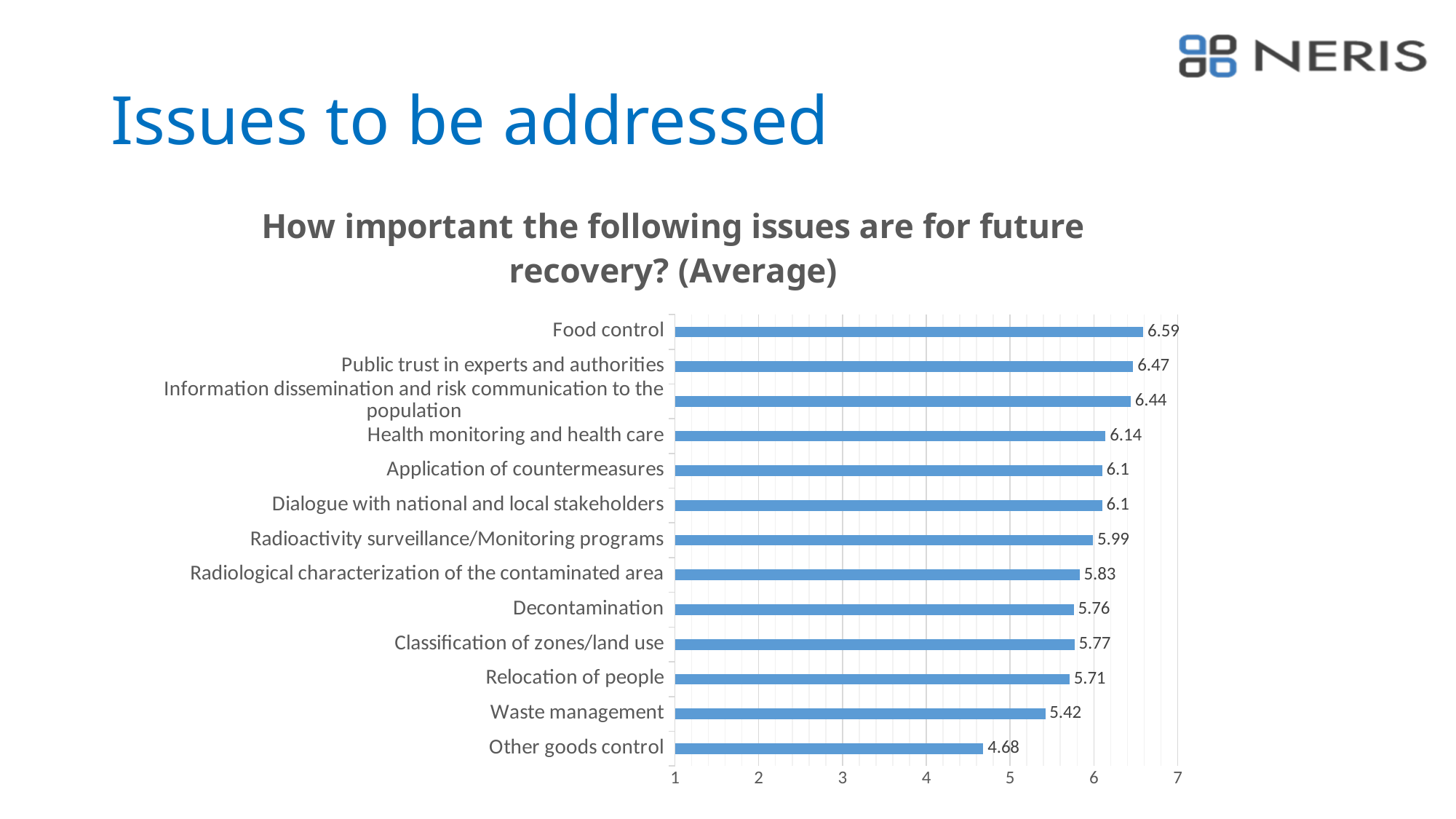
What is the difference between the values for Public trust in experts and authorities and Health monitoring and health care? 0.33 Which issue has the lowest average importance? Other goods control What is the value shown for Radiological characterization of the contaminated area? 5.83 Which has a larger value, Relocation of people or Waste management? Relocation of people Which issue has the highest average importance? Food control What kind of chart is shown on the slide? Bar chart What is the title of the chart? How important the following issues are for future recovery? (Average) What is the average importance value for Food control? 6.59 How many issues are listed in the chart? 13 What is the difference between the values for Food control and Other goods control? 1.91 What is the value shown for Waste management? 5.42 Is the value for Other goods control greater or less than 5? less